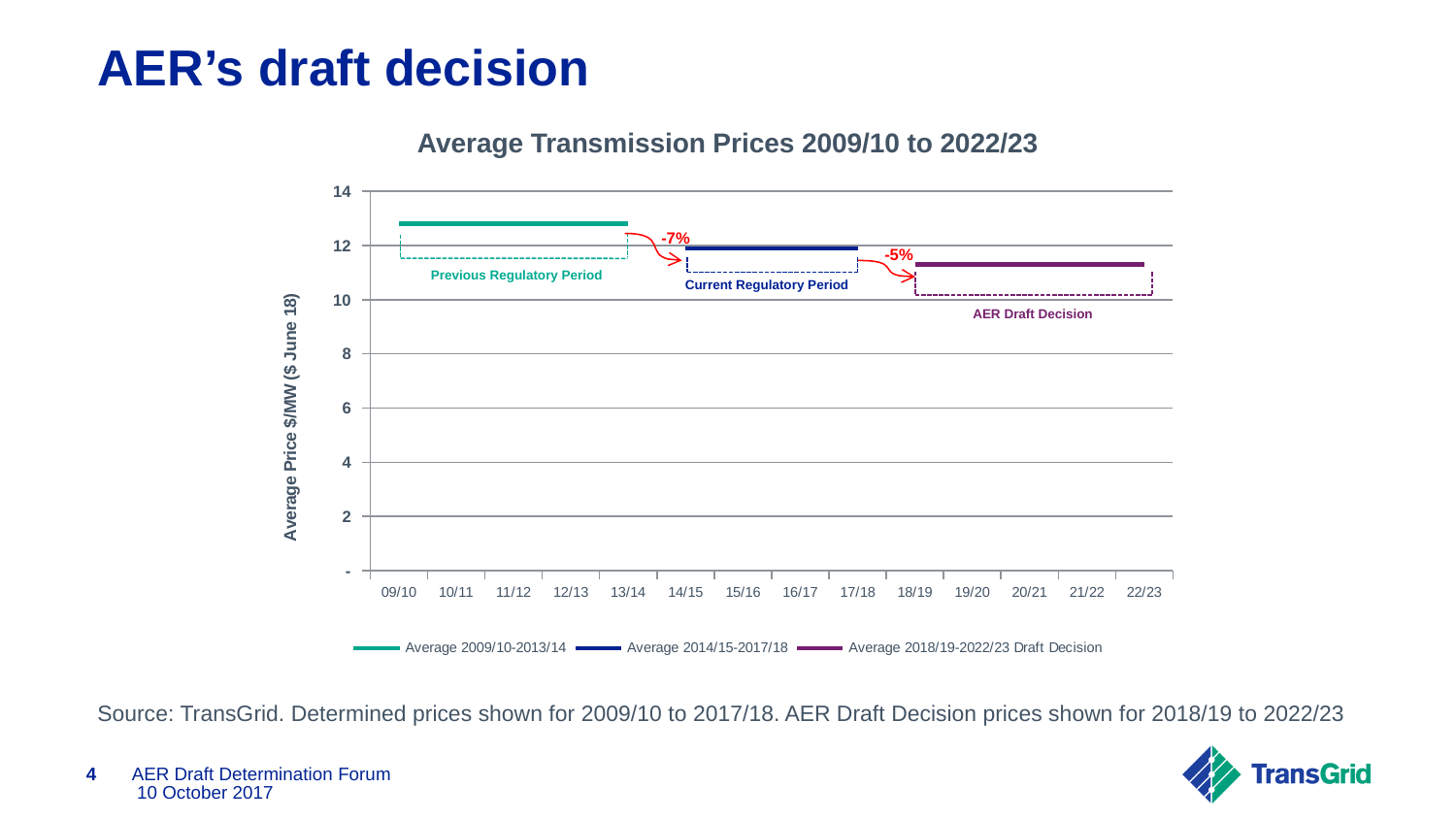
What is the y-axis label of the chart? Average Price $/MW ($ June 18) Is the value for the Average 2009/10-2013/14 series greater or less than 12? greater What percentage change is labelled between the Previous Regulatory Period and the Current Regulatory Period? -7% Which series has the highest average price? Average 2009/10-2013/14 Do the average transmission prices rise or fall across the periods from 2009/10 to 2022/23? fall How many year categories are shown on the x axis? 14 What kind of chart is shown on the slide? line chart Is the value for the Average 2018/19-2022/23 Draft Decision series greater or less than 12? less Is the value for the Average 2014/15-2017/18 series greater or less than 10? greater How many series does the chart legend list? 3 What percentage change is labelled between the Current Regulatory Period and the AER Draft Decision? -5% What is the title of the chart? Average Transmission Prices 2009/10 to 2022/23